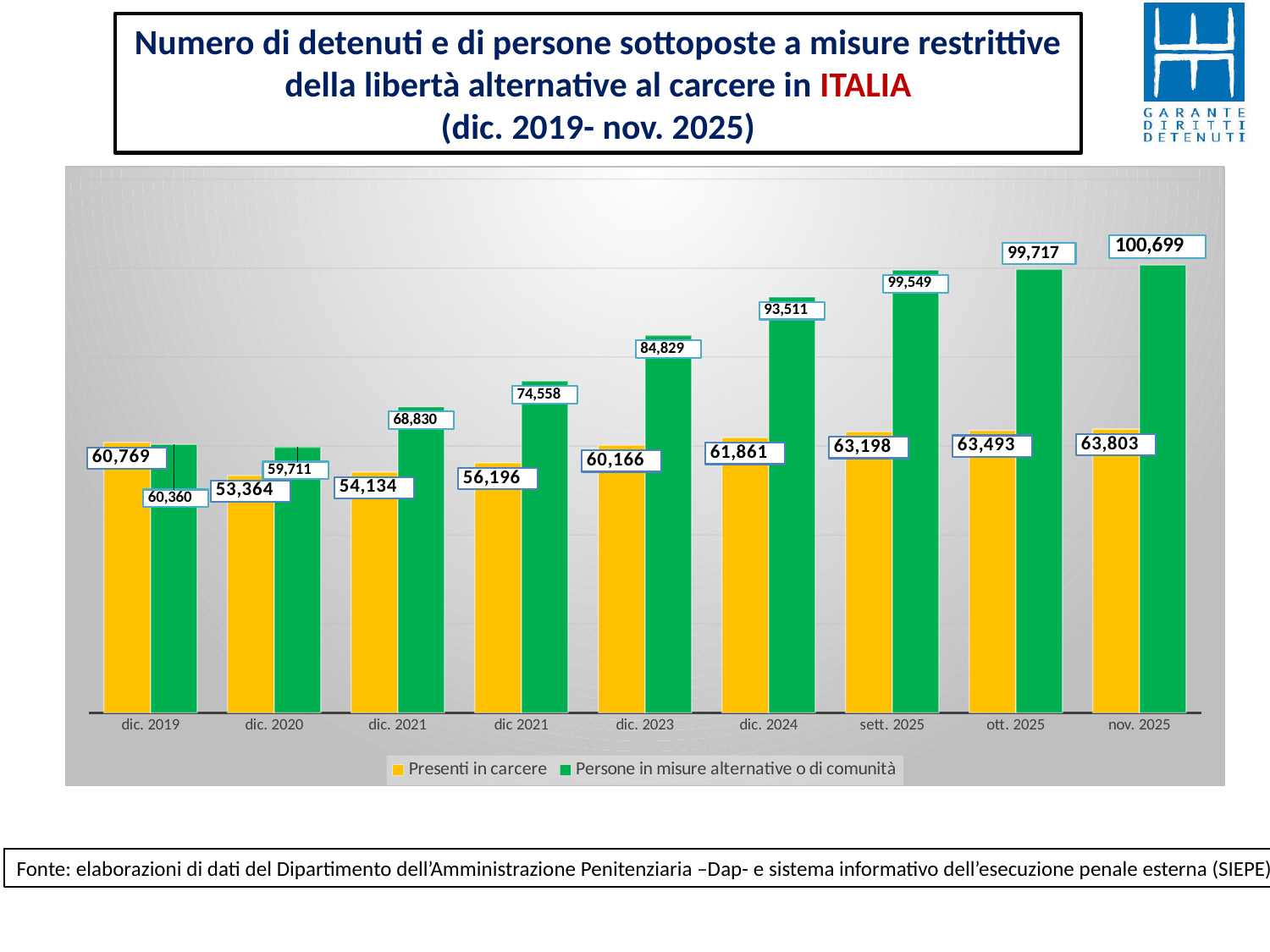
In which period is the value of "Persone in misure alternative o di comunità" highest? nov. 2025 What is the value of "Presenti in carcere" for nov. 2025? 63,803 What is the value of "Persone in misure alternative o di comunità" for dic. 2024? 93,511 How many series does the legend list? 2 How many periods are shown on the x axis? 9 What colour represents "Presenti in carcere" in the legend? Yellow For dic. 2019, which is larger: "Presenti in carcere" or "Persone in misure alternative o di comunità"? Presenti in carcere What is the difference in "Presenti in carcere" between ott. 2025 and sett. 2025? 295 In which period is the value of "Presenti in carcere" lowest? dic. 2020 What kind of chart is shown on the slide? Bar chart For nov. 2025, what is the difference between "Persone in misure alternative o di comunità" and "Presenti in carcere"? 36,896 Does the value of "Persone in misure alternative o di comunità" generally rise or fall from dic. 2019 to nov. 2025? Rise